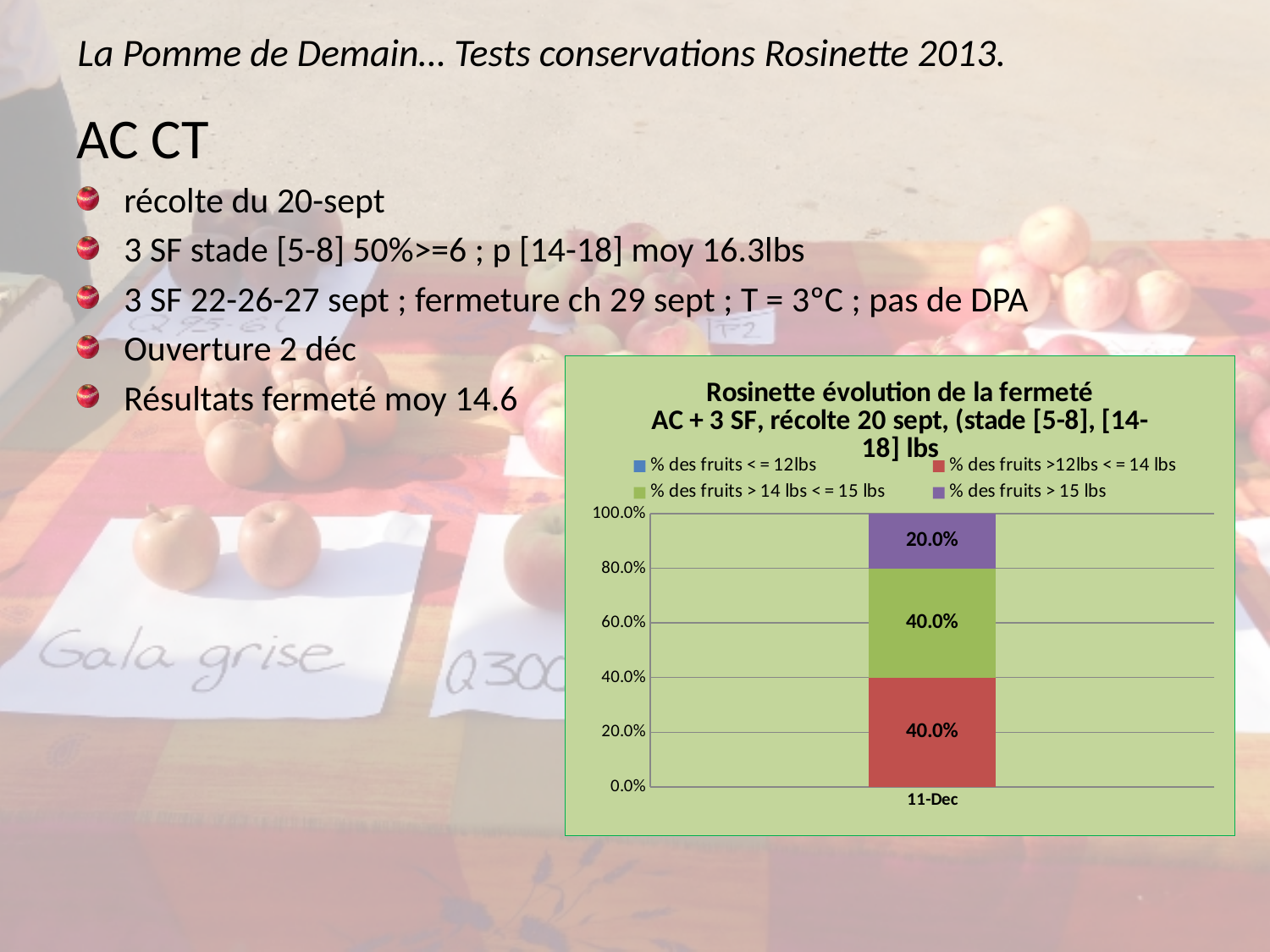
Which is larger on 11-Dec: '% des fruits >12lbs < = 14 lbs' or '% des fruits > 15 lbs'? % des fruits >12lbs < = 14 lbs What colour is the '% des fruits > 15 lbs' segment in the chart? purple What is the value for '% des fruits > 14 lbs < = 15 lbs' on 11-Dec? 40.0% What is the category label on the x axis of the chart? 11-Dec How many categories are shown on the x axis of the chart? 1 How many series does the chart legend list? 4 Which series has the smallest labelled segment in the 11-Dec bar? % des fruits > 15 lbs What is the difference between the '% des fruits > 14 lbs < = 15 lbs' segment and the '% des fruits > 15 lbs' segment on 11-Dec? 20.0% What is the value for '% des fruits > 15 lbs' on 11-Dec? 20.0% What kind of chart is shown on the slide? stacked bar chart What is the total of the labelled segments in the 11-Dec stacked bar? 100.0% What is the value for '% des fruits >12lbs < = 14 lbs' on 11-Dec? 40.0%